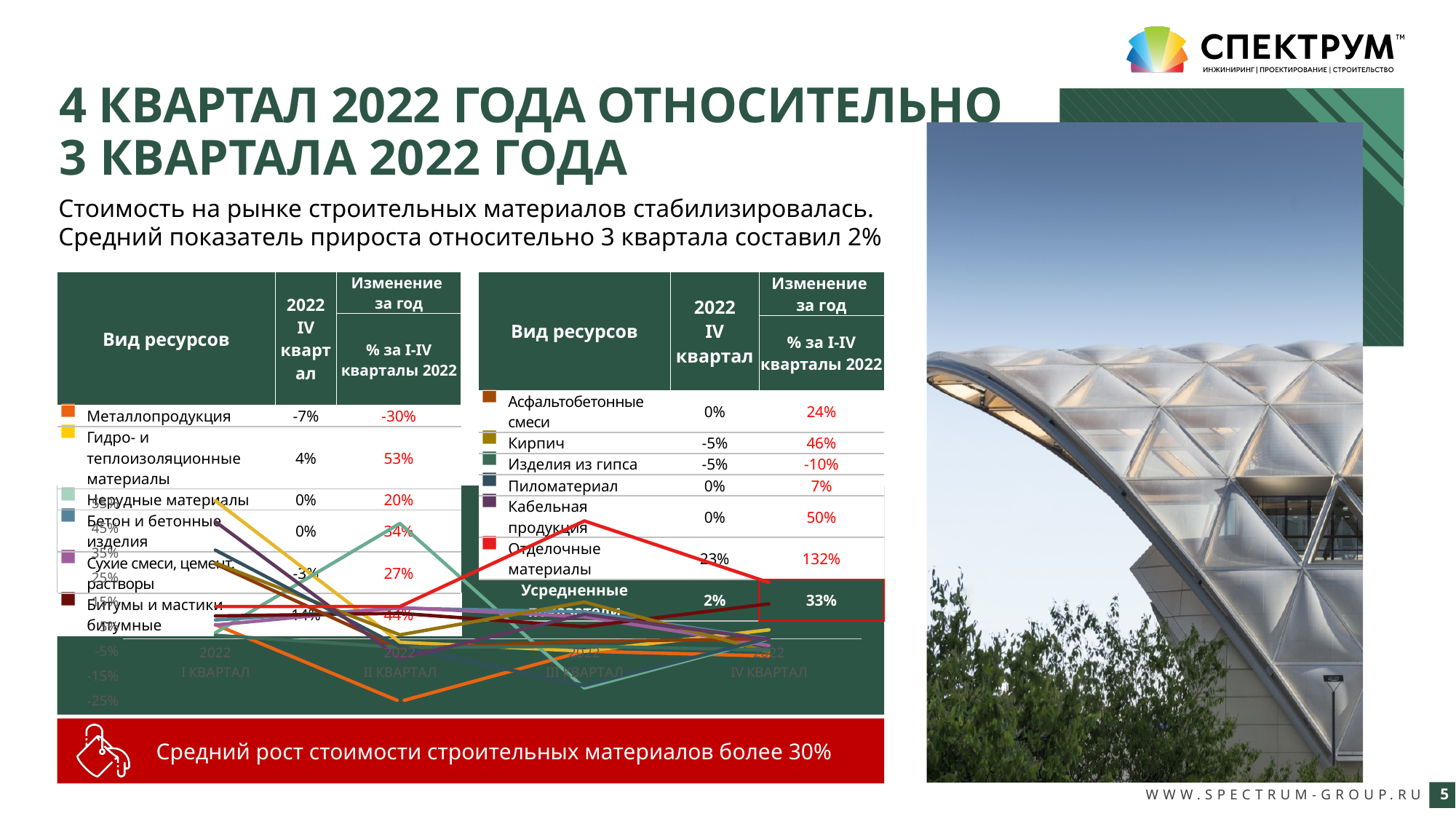
In the line chart, is the value of the orange line (Металлопродукция) at 2022 II квартал greater or less than -15%? less What is the highest tick value shown on the y axis of the line chart? 55% What is the lowest tick value shown on the y axis of the line chart? -25% What kind of chart is shown on the slide? line chart How many quarters are plotted along the x axis of the line chart? 4